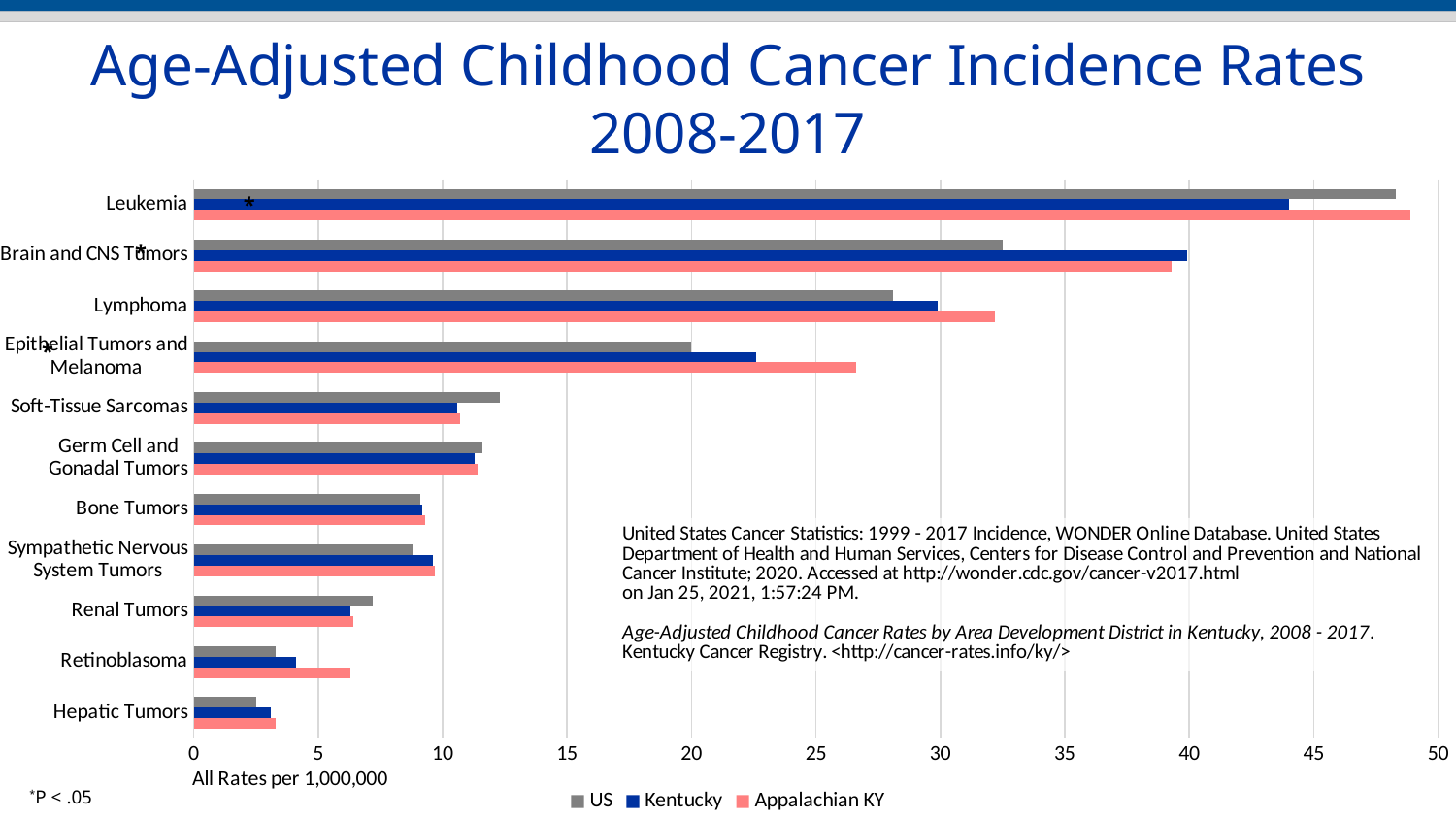
How many series does the legend list? 3 For Retinoblastoma, which is larger: the Appalachian KY rate or the US rate? Appalachian KY Is the US value for Hepatic Tumors greater or less than 5? less Is the Appalachian KY value for Lymphoma greater or less than 30? greater Which cancer type has the lowest Appalachian KY incidence rate? Hepatic Tumors What unit are the rates on the chart expressed in, according to the axis note? All Rates per 1,000,000 Which series is shown in grey in the legend? US Which cancer type has the highest US incidence rate? Leukemia How many cancer type categories are plotted on the chart? 11 Is the US value for Leukemia greater or less than 45? greater What kind of chart is shown on the slide? bar chart For Brain and CNS Tumors, which is larger: the Kentucky rate or the US rate? Kentucky